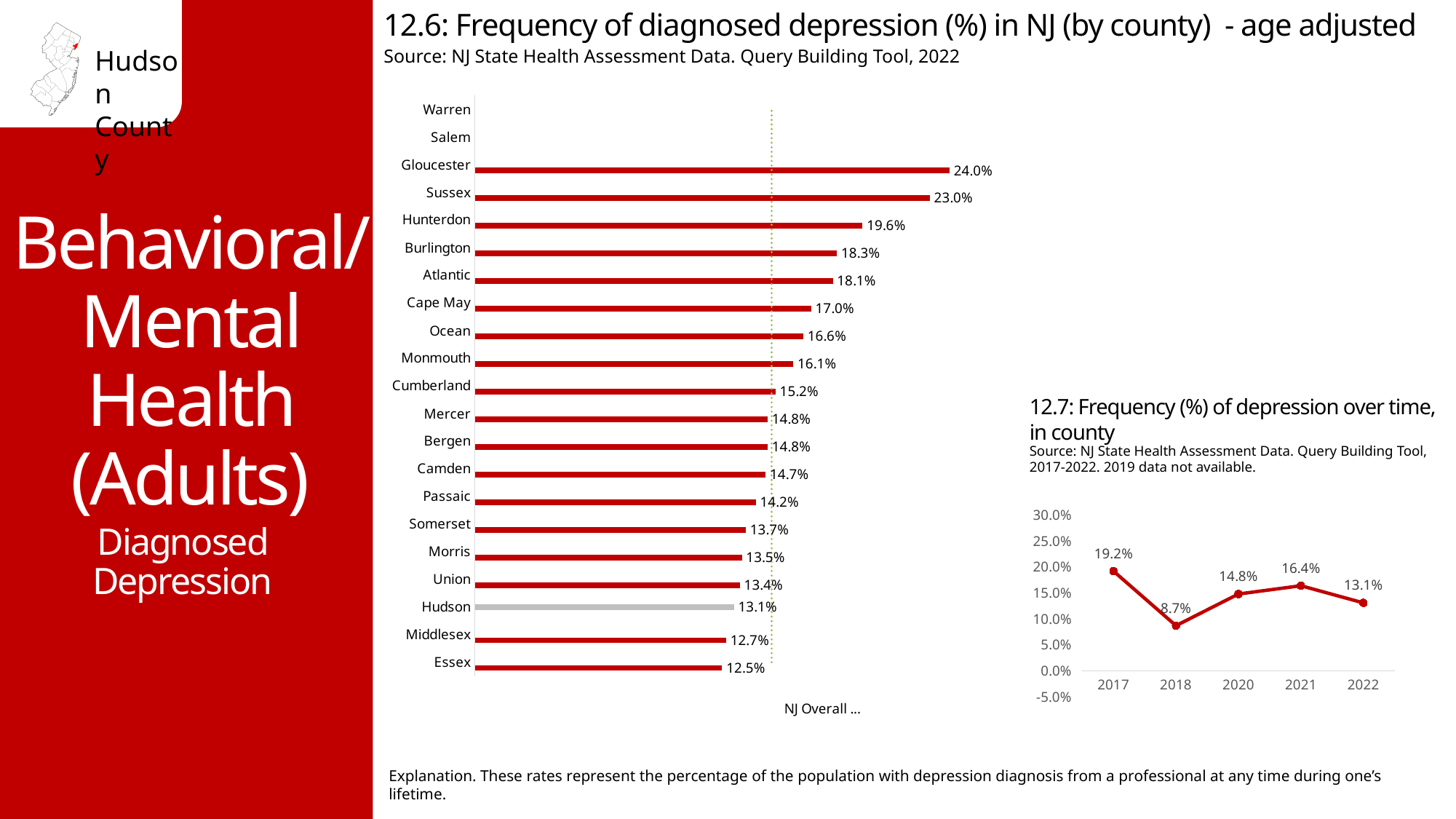
What type of chart is chart 12.6? Bar chart In chart 12.6, what is the frequency of diagnosed depression for Hudson County? 13.1% In chart 12.7, what is the difference between the 2021 and 2022 values? 3.3% In chart 12.6, which county has the highest frequency of diagnosed depression? Gloucester In chart 12.7, what is the frequency of depression in 2018? 8.7% In chart 12.7, which year has the highest frequency of depression? 2017 In chart 12.6, which has a higher value, Burlington or Cape May? Burlington In chart 12.6, what is the value shown for Gloucester? 24.0% In chart 12.7, is the value for 2020 greater or less than 10.0%? greater In chart 12.6, which county with a plotted bar has the lowest frequency of diagnosed depression? Essex In chart 12.7, how many years are plotted? 5 In chart 12.6, what is the difference between the values for Sussex and Hudson? 9.9%